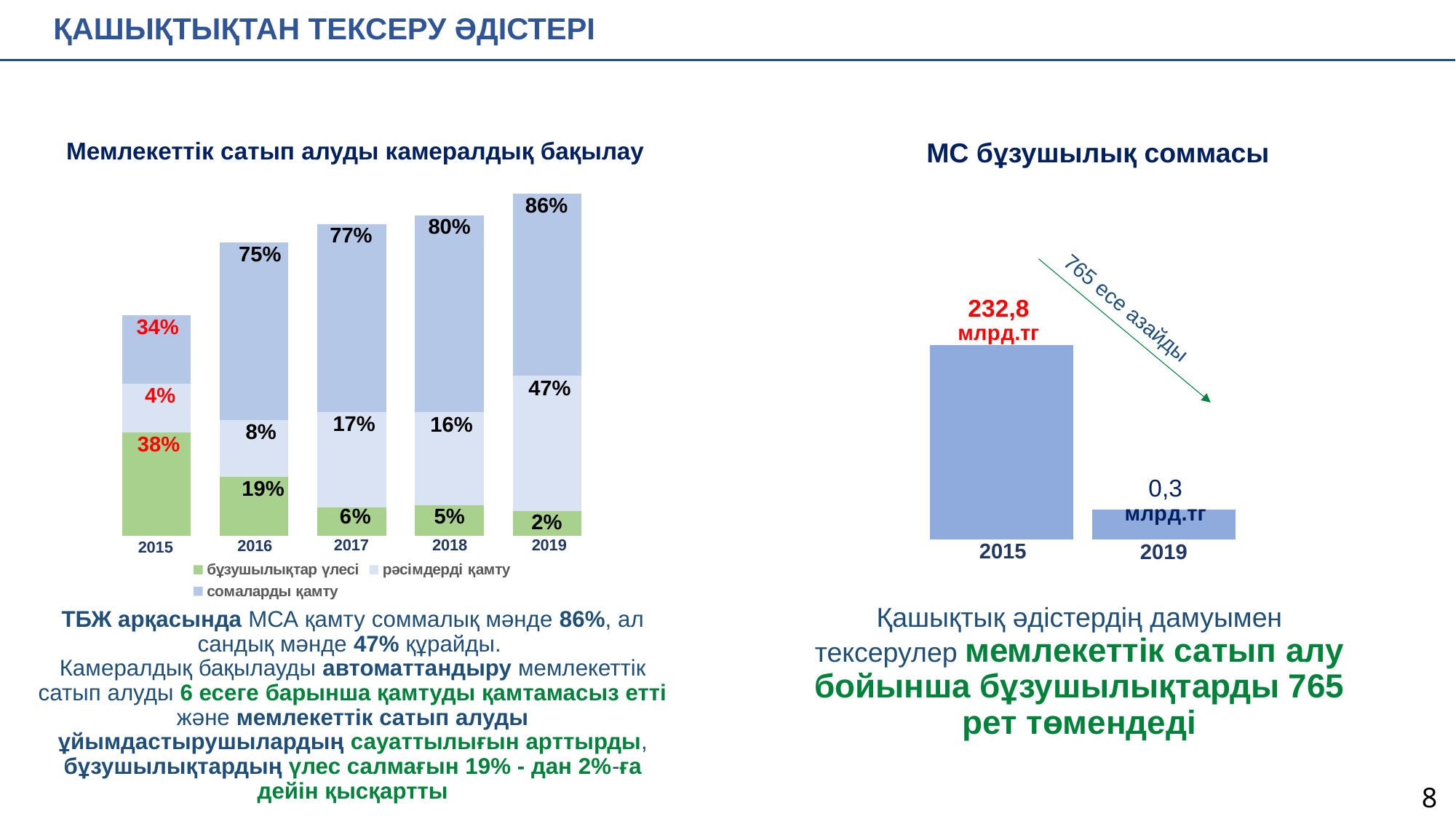
In the chart titled 'Мемлекеттік сатып алуды камералдық бақылау', what is the value of 'сомаларды қамту' for 2019? 86% In the chart titled 'Мемлекеттік сатып алуды камералдық бақылау', what is the value of 'бұзушылықтар үлесі' for 2015? 38% In the chart titled 'Мемлекеттік сатып алуды камералдық бақылау', how many series does the legend list? 3 In the chart titled 'Мемлекеттік сатып алуды камералдық бақылау', does the 'сомаларды қамту' series rise or fall from 2015 to 2019? rise What kind of chart is the chart titled 'МС бұзушылық соммасы'? bar chart In the chart titled 'МС бұзушылық соммасы', what is the value for 2015? 232,8 млрд.тг In the chart titled 'Мемлекеттік сатып алуды камералдық бақылау', which year has the lowest value for 'бұзушылықтар үлесі'? 2019 In the chart titled 'Мемлекеттік сатып алуды камералдық бақылау', which year has the highest value for 'сомаларды қамту'? 2019 In the chart titled 'Мемлекеттік сатып алуды камералдық бақылау', what is the difference between the 'сомаларды қамту' values for 2019 and 2015? 52% In the chart titled 'МС бұзушылық соммасы', what is the value for 2019? 0,3 млрд.тг In the chart titled 'Мемлекеттік сатып алуды камералдық бақылау', how many years are shown on the x axis? 5 In the chart titled 'Мемлекеттік сатып алуды камералдық бақылау', what is the value of 'рәсімдерді қамту' for 2017? 17%